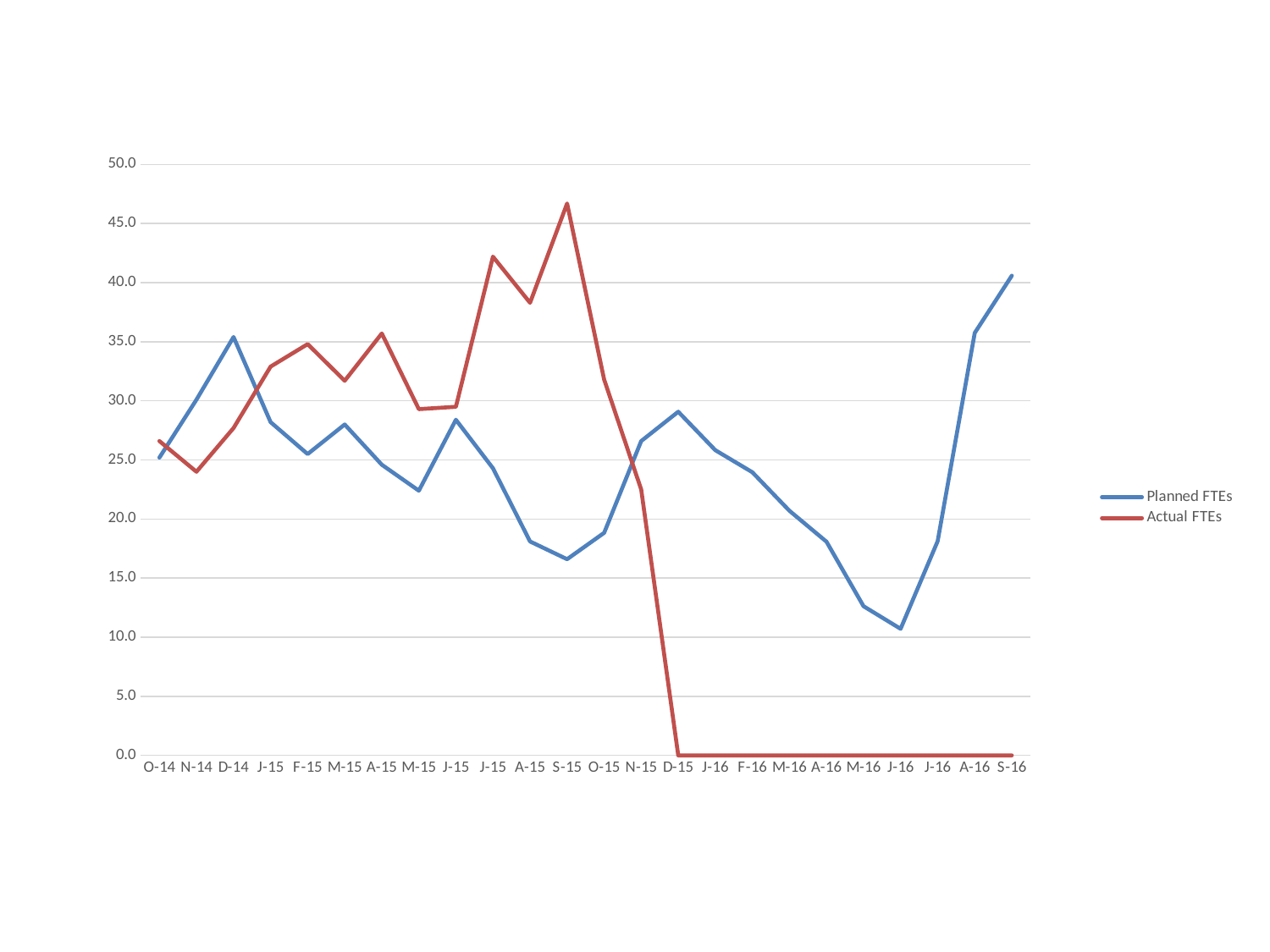
At which month does the Planned FTEs series reach its highest value? S-16 At which month does the Planned FTEs series reach its lowest value? J-16 How many series does the legend list? 2 At S-15, which series has the larger value, Planned FTEs or Actual FTEs? Actual FTEs Is the value for Actual FTEs at S-15 greater or less than 45.0? greater At which month does the Actual FTEs series reach its highest value? S-15 What is the value of Actual FTEs at M-16? 0.0 What kind of chart is shown on the slide? line chart Which colour is used for the Planned FTEs line? blue Does the Actual FTEs series rise or fall between S-15 and D-15? fall How many points are plotted along the x axis for each series? 24